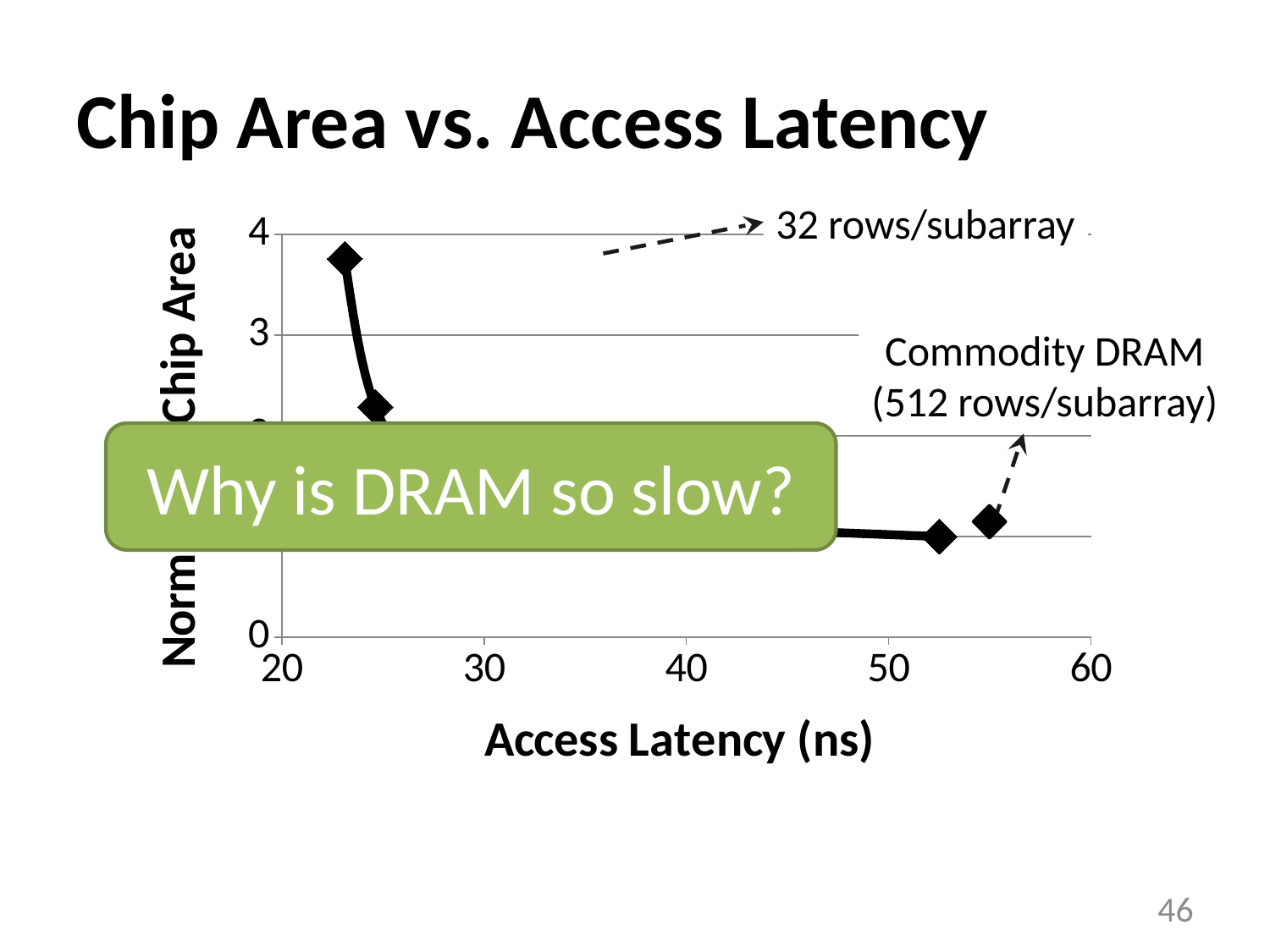
What kind of chart is shown on the slide? line chart Which has the lower access latency: the 32 rows/subarray configuration or Commodity DRAM (512 rows/subarray)? 32 rows/subarray Which configuration is annotated as having the highest normalized chip area on the chart? 32 rows/subarray Which has the larger normalized chip area: the 32 rows/subarray configuration or Commodity DRAM (512 rows/subarray)? 32 rows/subarray What is the label of the x axis of the chart? Access Latency (ns) Is the normalized chip area for the Commodity DRAM (512 rows/subarray) point greater or less than 2? less Is the access latency for the Commodity DRAM (512 rows/subarray) point greater or less than 50 ns? greater What is the title of the chart on the slide? Chip Area vs. Access Latency Is the normalized chip area for the 32 rows/subarray point greater or less than 3? greater Overall, does the normalized chip area rise or fall as access latency increases along the x axis? fall